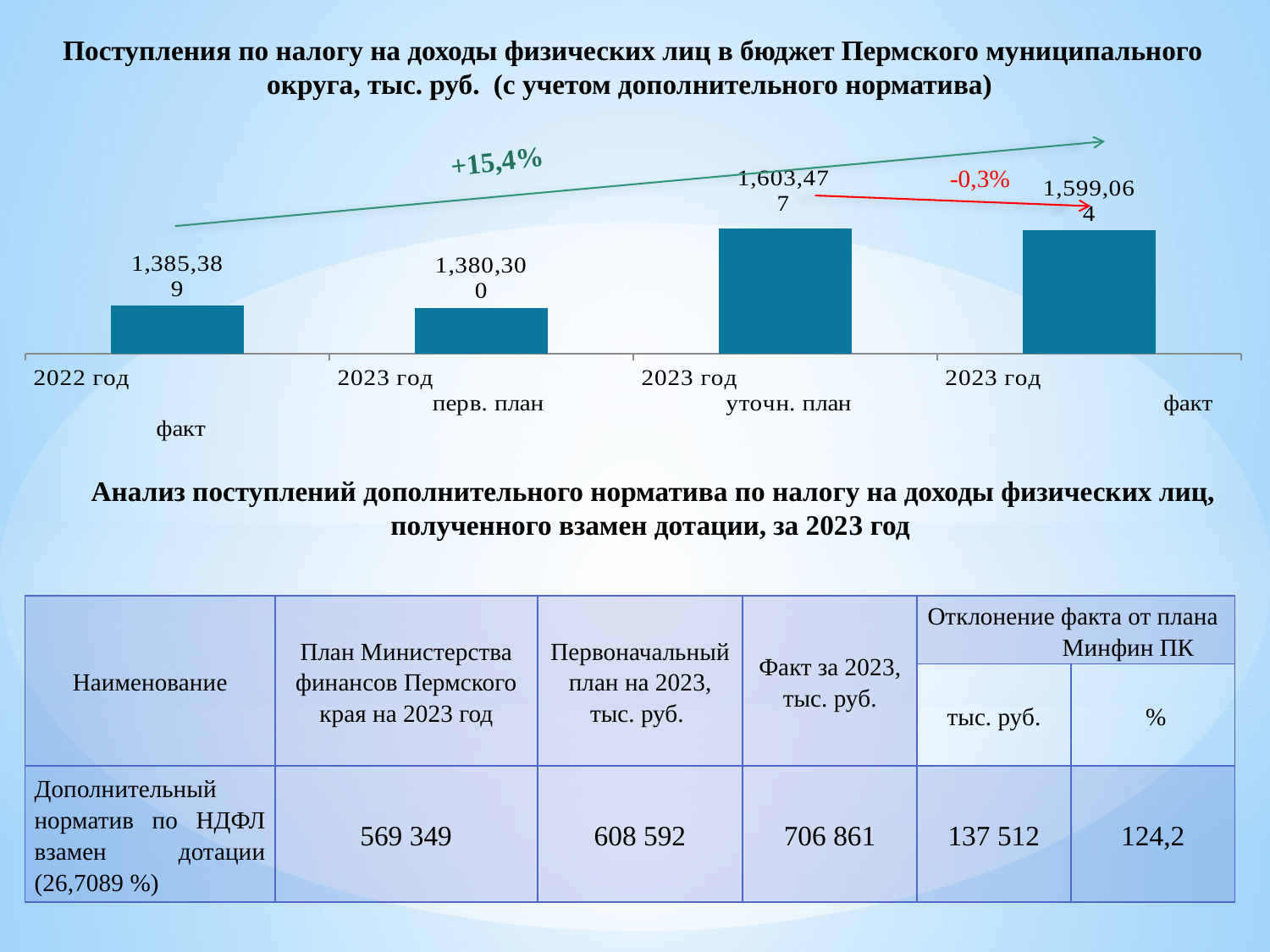
What percentage change is shown by the green arrow annotation on the chart? +15,4% Which category has the lowest value in the bar chart? 2023 год перв. план What is the difference between the values for 2023 год уточн. план and 2023 год факт? 4,413 What is the value for 2023 год перв. план? 1,380,300 What is the difference between the values for 2023 год уточн. план and 2023 год перв. план? 223,177 What is the value for 2023 год факт? 1,599,064 What is the value for 2023 год уточн. план? 1,603,477 Which is larger, the value for 2023 год факт or the value for 2022 год факт? 2023 год факт What is the value for 2022 год факт? 1,385,389 Which category has the highest value in the bar chart? 2023 год уточн. план What kind of chart is shown on the slide? bar chart How many bars are shown in the chart? 4